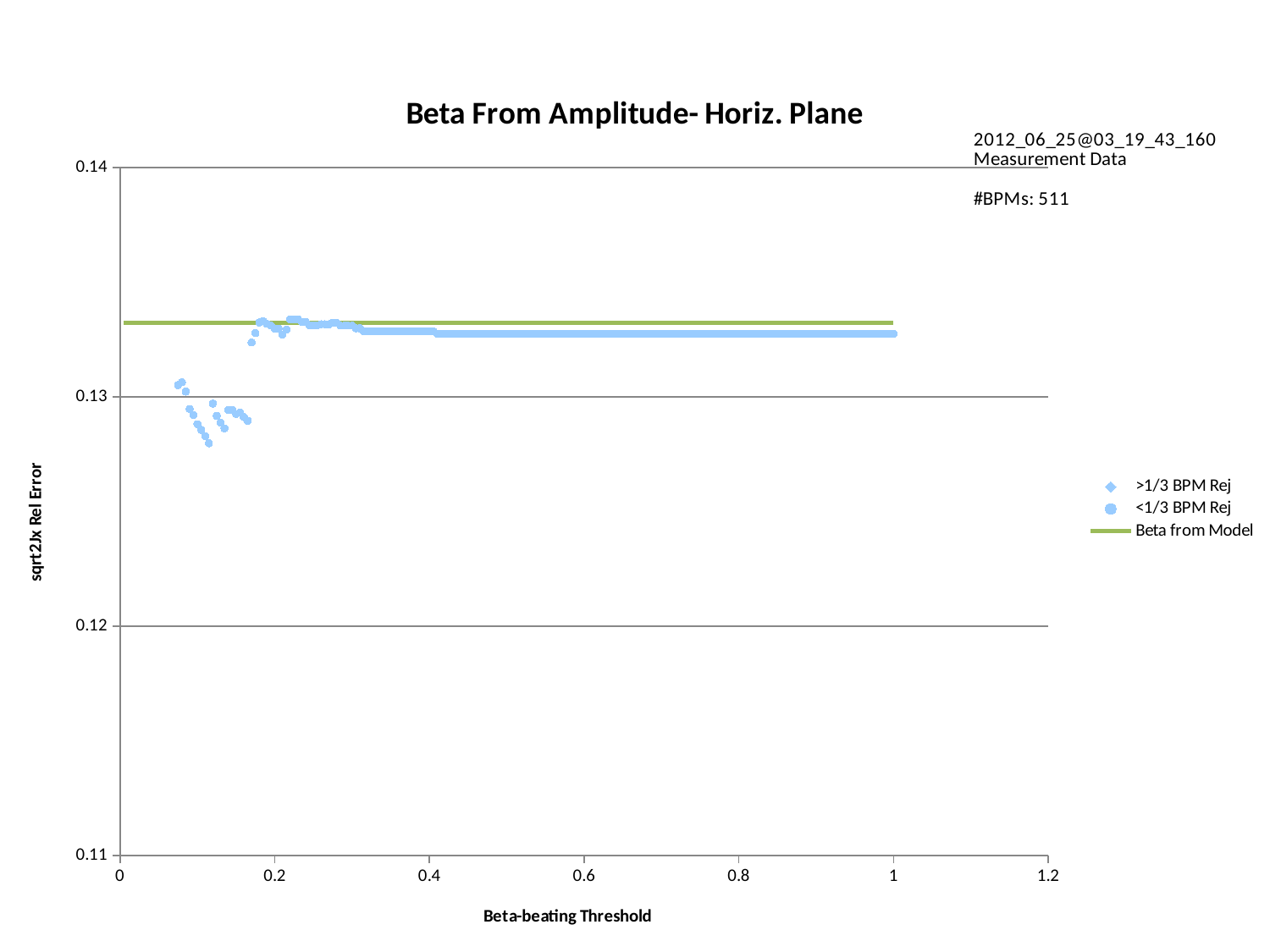
Is the lowest <1/3 BPM Rej point greater or less than 0.13? less What is the label of the x axis? Beta-beating Threshold Is the value of the Beta from Model line greater or less than 0.13? greater What is the highest value shown on the y axis? 0.14 Do the <1/3 BPM Rej values rise or fall between a Beta-beating Threshold of 0.1 and 0.2? rise At a Beta-beating Threshold of about 0.1, which is larger: the <1/3 BPM Rej value or the Beta from Model line? Beta from Model Is the lowest <1/3 BPM Rej point greater or less than 0.12? greater What is the title of the chart? Beta From Amplitude- Horiz. Plane What kind of chart is shown on the slide? scatter chart How many series does the legend list? 3